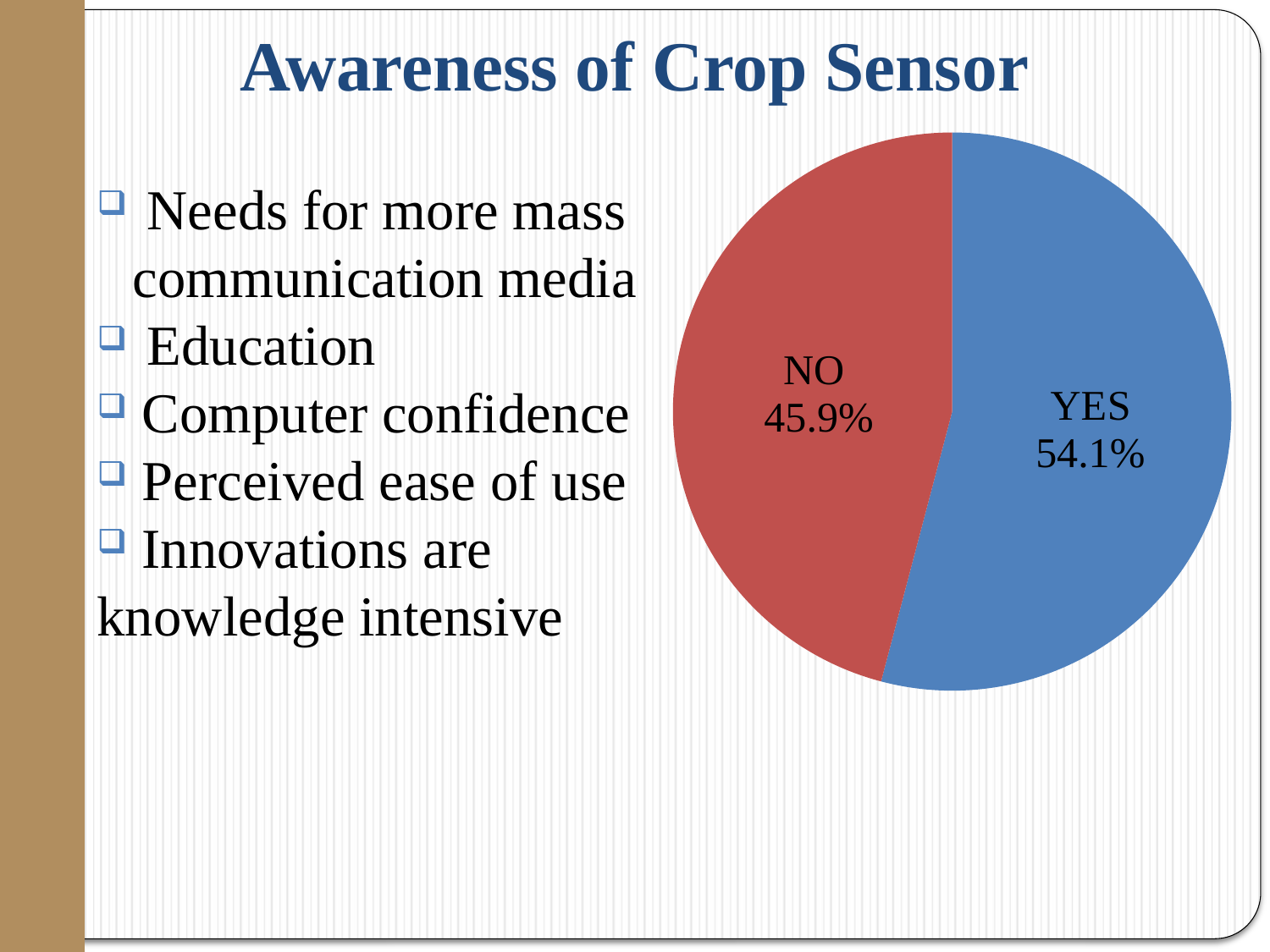
What is the difference in percentage points between the YES and NO slices? 8.2 Is the YES slice greater or less than 50%? greater Which slice of the pie is the largest? YES Is the NO slice greater or less than 50%? less What colour is the NO slice of the pie? red What percentage of the pie is labelled NO? 45.9% What percentage of the pie is labelled YES? 54.1% How many slices does the pie chart have? 2 Which is larger, the YES slice or the NO slice? YES What kind of chart is shown on the slide? pie chart Which slice of the pie is the smallest? NO What colour is the YES slice of the pie? blue